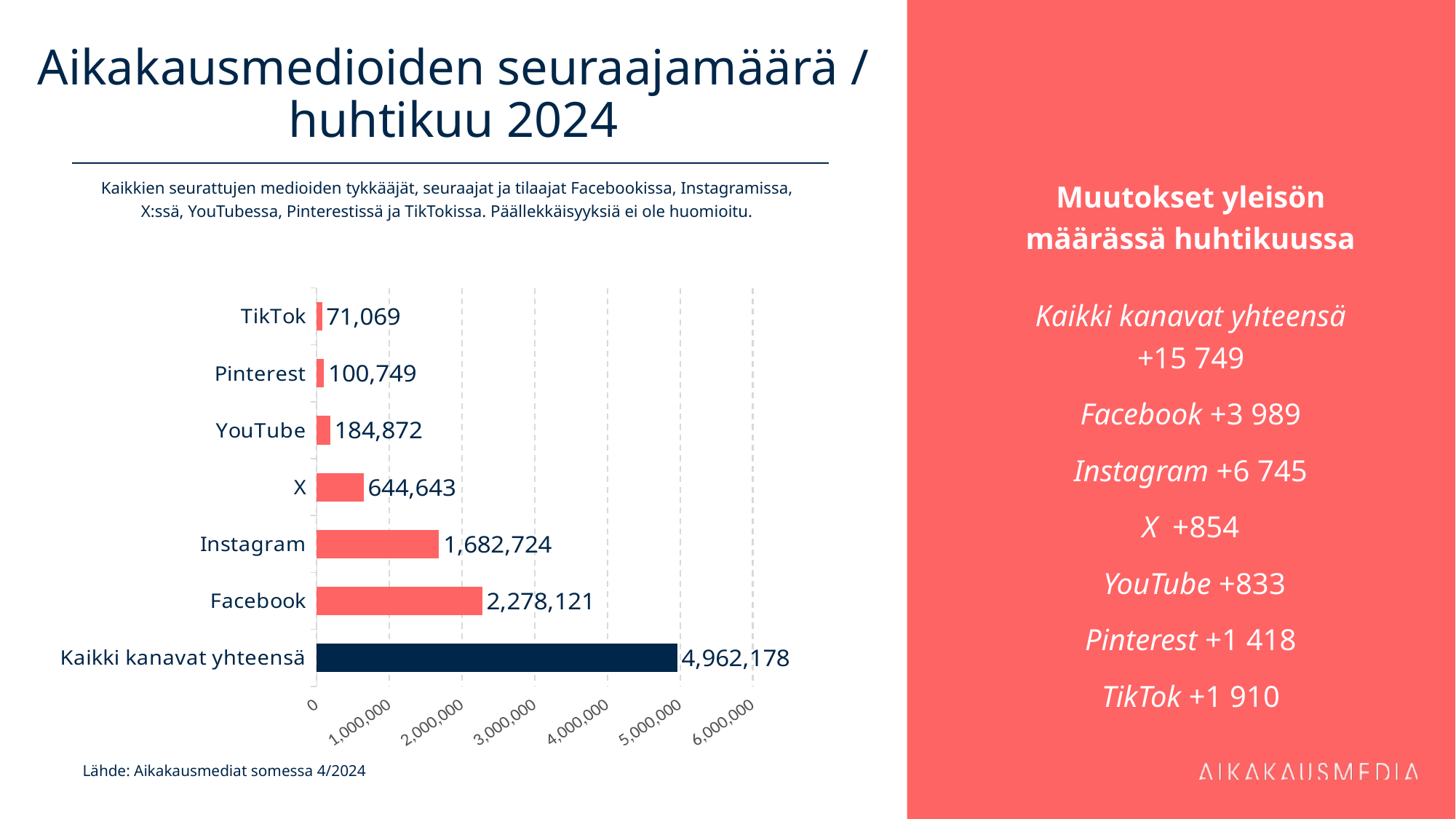
Which category has the lowest value in the bar chart? TikTok Which individual channel (excluding the total bar) has the highest value? Facebook What kind of chart is shown on the slide? bar chart What is the difference between the values for Pinterest and TikTok? 29,680 What is the value for Kaikki kanavat yhteensä in the bar chart? 4,962,178 Is the value for X greater or less than 1,000,000? less What is the value for TikTok in the bar chart? 71,069 How many categories are shown in the bar chart? 7 What is the value for Facebook in the bar chart? 2,278,121 Which is larger, the value for X or the value for YouTube? X What is the difference between the values for Facebook and Instagram? 595,397 What is the value for Instagram in the bar chart? 1,682,724